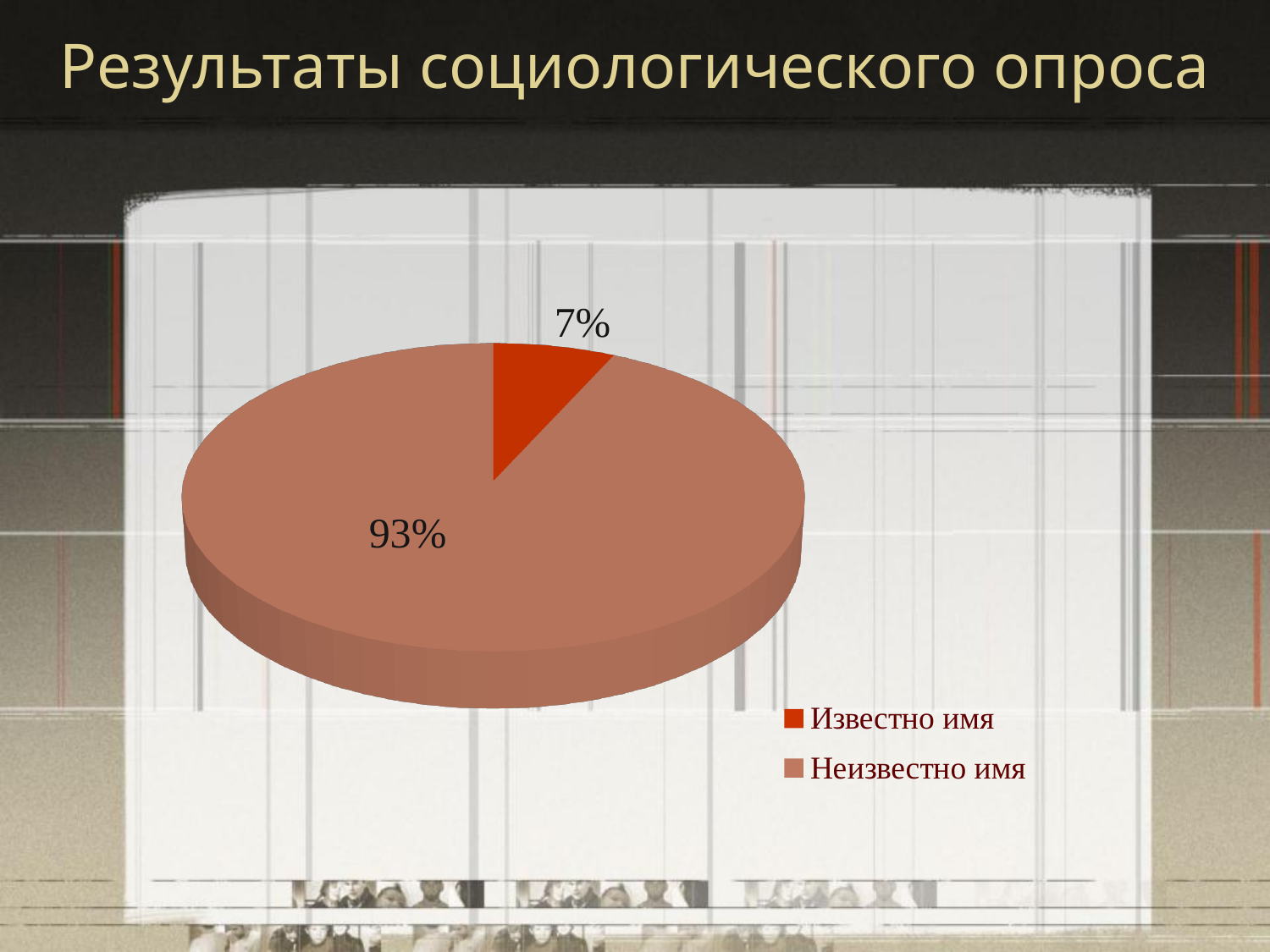
What is the difference in percentage points between the "Неизвестно имя" and "Известно имя" slices? 86 Which is larger: the "Известно имя" slice or the "Неизвестно имя" slice? Неизвестно имя Which slice of the pie is the smallest? Известно имя How many entries does the legend list? 2 What share of the pie does "Неизвестно имя" represent? 93% What share of the pie does "Известно имя" represent? 7% What colour is the "Известно имя" slice in the pie chart? red Which slice of the pie is the largest? Неизвестно имя What is the title of the slide containing the chart? Результаты социологического опроса What kind of chart is shown on the slide? pie chart How many slices does the pie chart have? 2